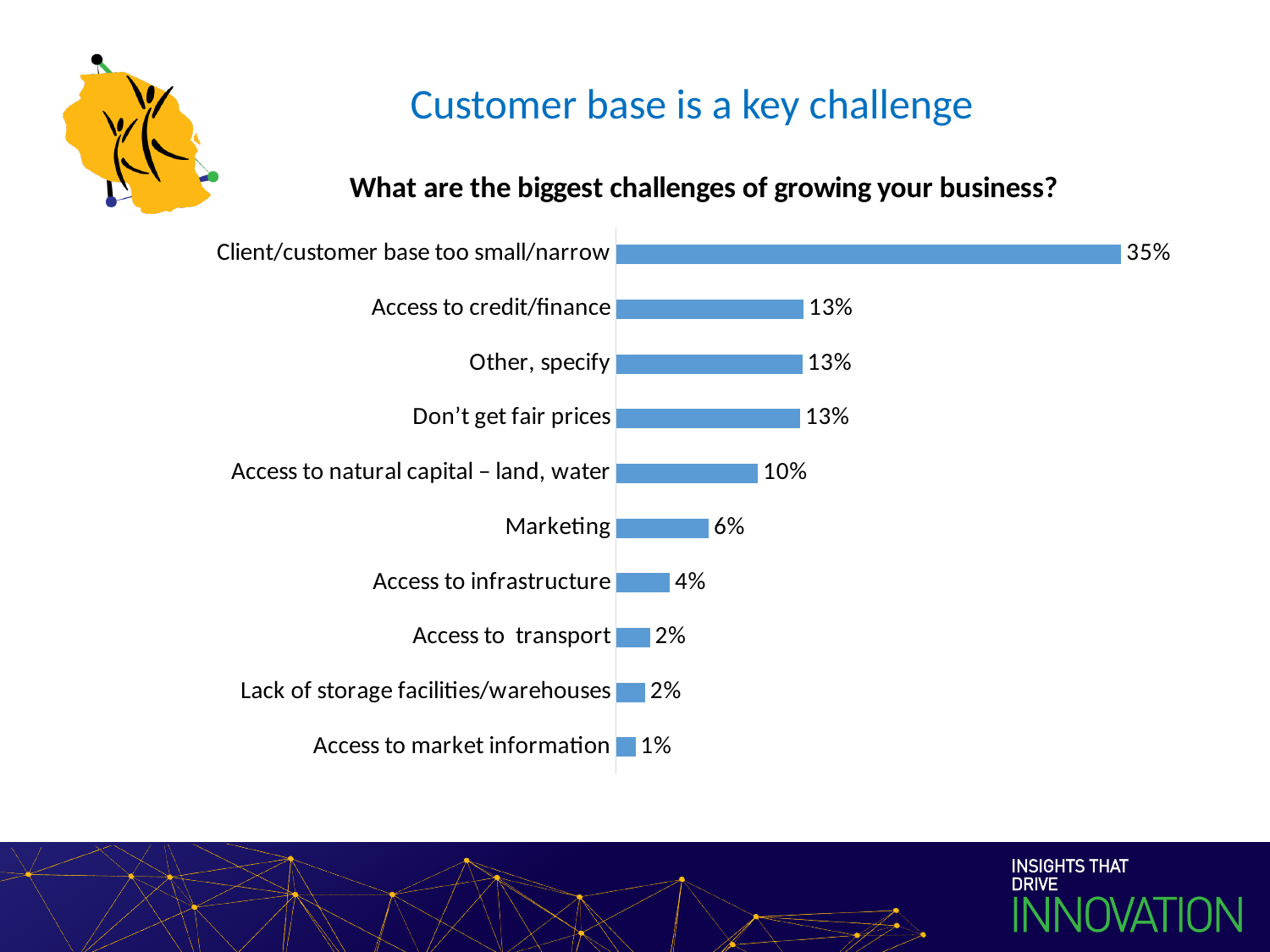
What percentage of respondents cited 'Client/customer base too small/narrow' as a challenge? 35% Which challenge has the lowest percentage? Access to market information What is the difference between the values for 'Access to natural capital – land, water' and 'Marketing'? 4% Which challenge has the highest percentage? Client/customer base too small/narrow What is the difference between the values for 'Client/customer base too small/narrow' and 'Access to credit/finance'? 22% What kind of chart is shown on the slide? Bar chart What is the value shown for 'Access to natural capital – land, water'? 10% How many challenge categories are shown in the chart? 10 What question is the chart answering, as stated above it? What are the biggest challenges of growing your business? Which is larger: the value for 'Marketing' or the value for 'Access to infrastructure'? Marketing What is the value shown for 'Marketing'? 6% What is the value shown for 'Access to infrastructure'? 4%